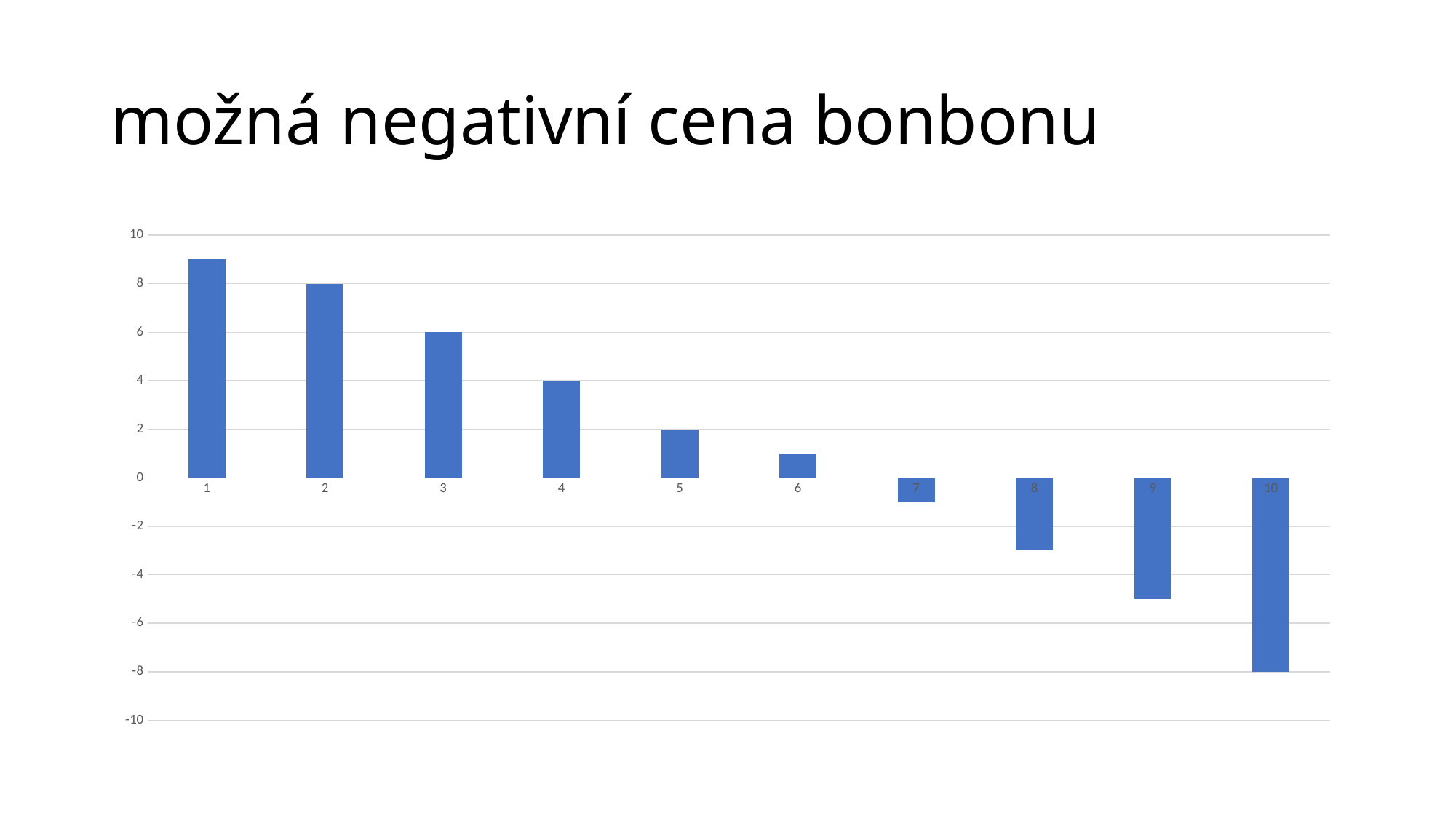
Which category has the lowest value? 10 What is the title of the slide? možná negativní cena bonbonu Do the values rise or fall from category 1 to category 10? fall How many categories are plotted on the x axis? 10 What kind of chart is shown on the slide? bar chart Is the value for category 1 greater or less than 8? greater Is the value for category 9 greater or less than -4? less What is the value for category 2? 8 What is the difference between the values for category 2 and category 4? 4 What is the value for category 3? 6 Which category has the highest value? 1 What is the value for category 10? -8